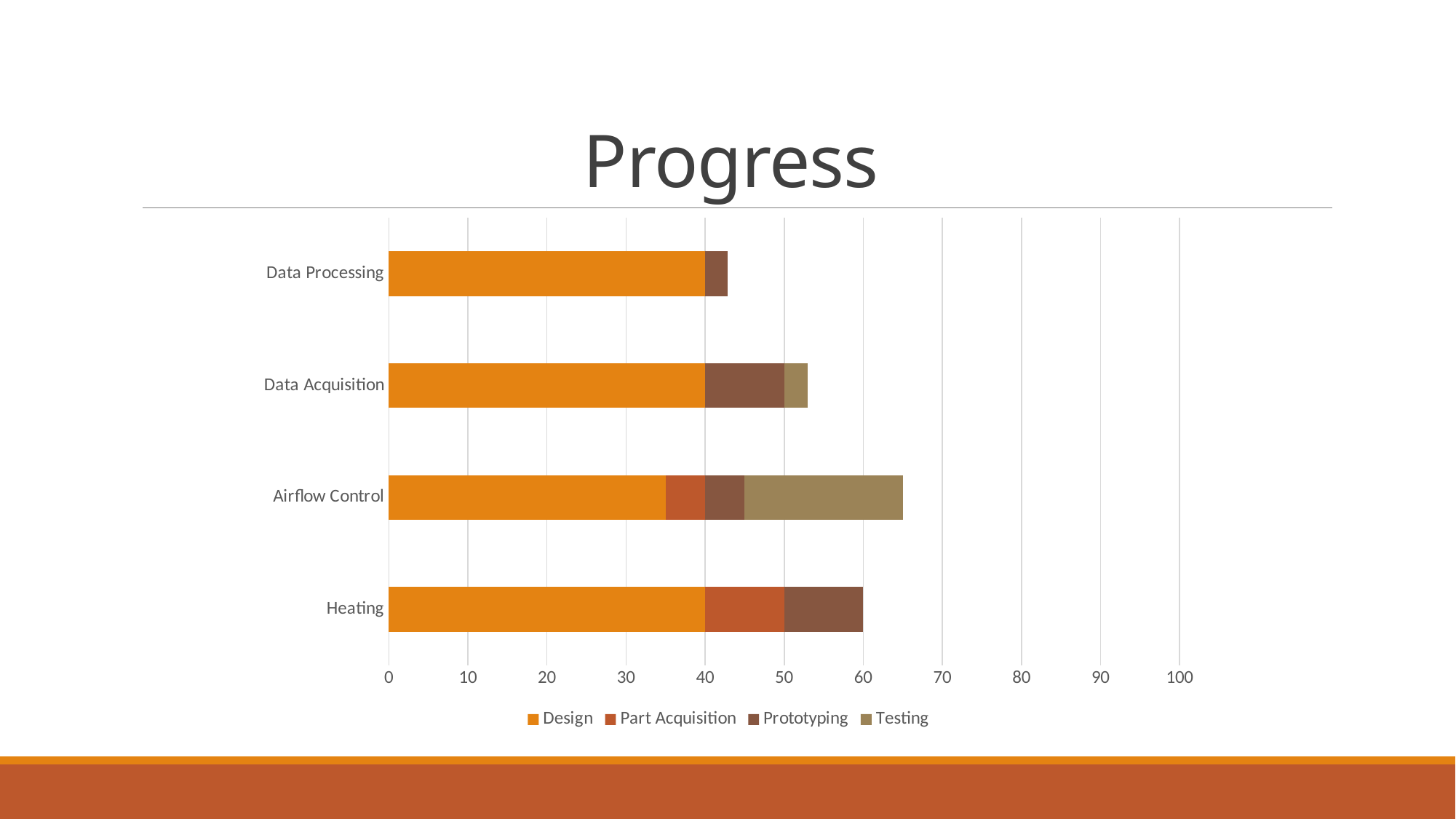
Which has the larger total bar, Heating or Data Acquisition? Heating What kind of chart is shown on the slide? Stacked bar chart What is the title of the chart? Progress What is the Design value for Heating? 40 Is the total bar for Airflow Control greater or less than 60? greater Which category has the longest total bar? Airflow Control Which category has the shortest total bar? Data Processing What is the total of the stacked bar for Heating? 60 How many series does the legend list? 4 Is the Design value for Airflow Control greater or less than 40? less How many categories are plotted on the chart? 4 Which category is the only one with a Testing segment larger than 10? Airflow Control